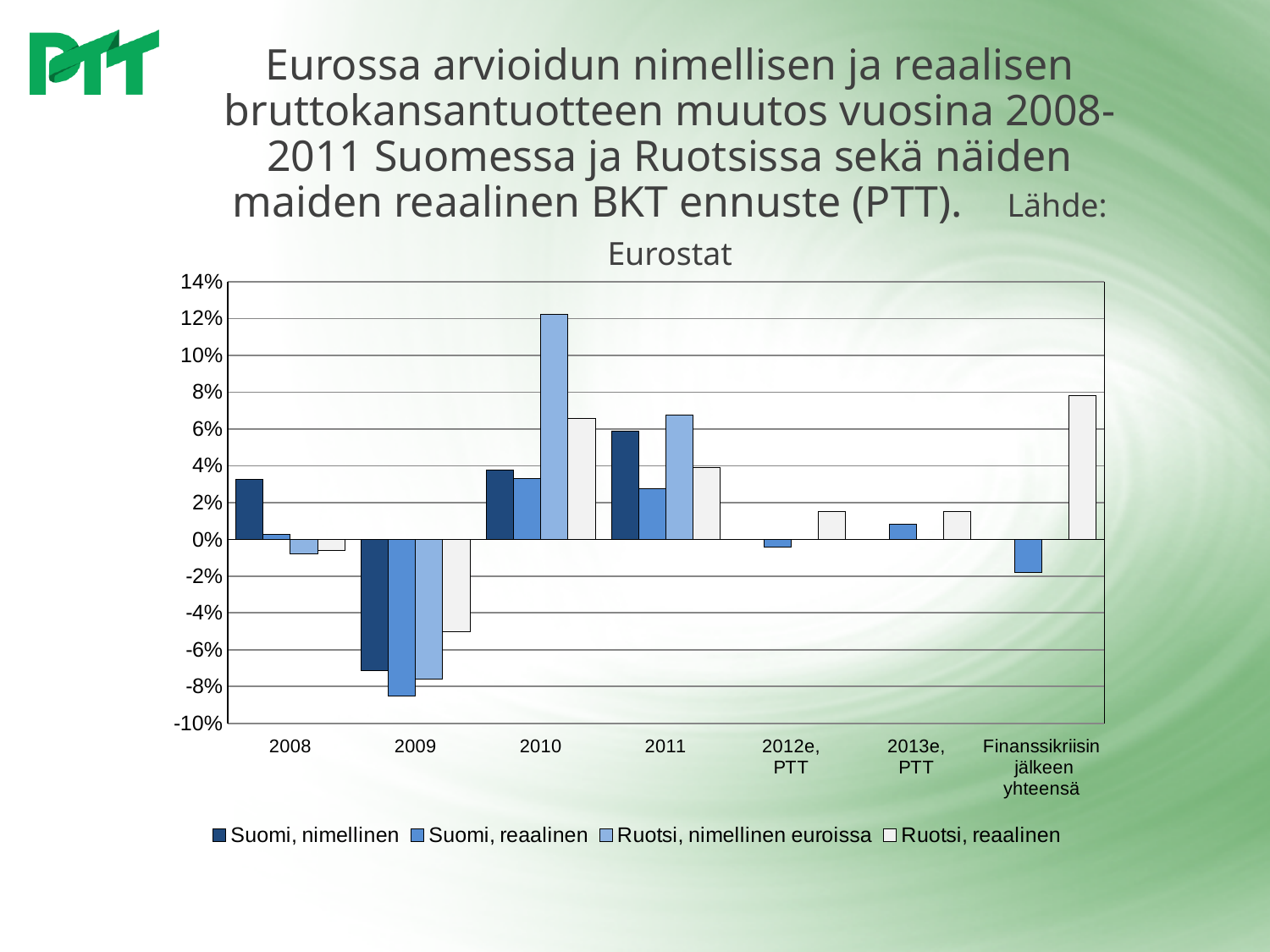
In which category is the Suomi, reaalinen bar lowest? 2009 In which category is the Ruotsi, nimellinen euroissa bar highest? 2010 What kind of chart is shown on the slide? bar chart What source is cited for the chart data? Eurostat In the Finanssikriisin jälkeen yhteensä category, which is larger: Suomi, reaalinen or Ruotsi, reaalinen? Ruotsi, reaalinen In 2011, which is larger: Suomi, nimellinen or Suomi, reaalinen? Suomi, nimellinen How many categories are shown along the x axis? 7 Does the Suomi, nimellinen value rise or fall from 2009 to 2011? rise How many series does the legend list? 4 Is the value for Suomi, reaalinen in 2009 greater or less than -8%? less Is the value for Ruotsi, nimellinen euroissa in 2010 greater or less than 10%? greater Is the value for Ruotsi, reaalinen in the Finanssikriisin jälkeen yhteensä category greater or less than 6%? greater